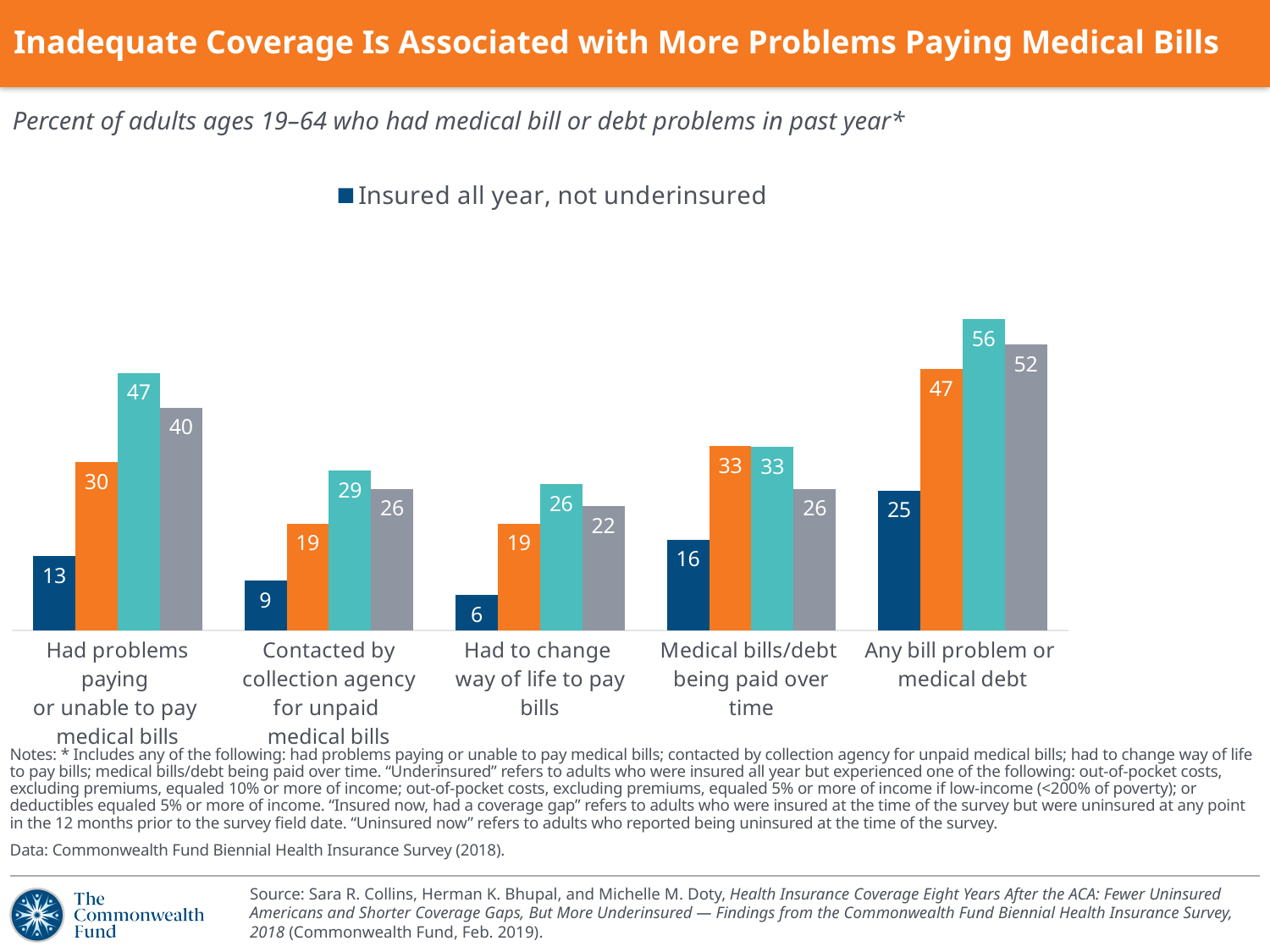
What is the value for 'Insured all year, not underinsured' in the 'Contacted by collection agency for unpaid medical bills' category? 9 In which category is the 'Insured all year, not underinsured' value highest? Any bill problem or medical debt What series name is shown in the chart's legend? Insured all year, not underinsured What is the highest value shown by any bar in the 'Any bill problem or medical debt' category? 56 What type of chart is shown on the slide? bar chart Which is larger for 'Insured all year, not underinsured': the value for 'Medical bills/debt being paid over time' or the value for 'Had problems paying or unable to pay medical bills'? Medical bills/debt being paid over time How many series does the chart's legend list? 1 What is the value for 'Insured all year, not underinsured' in the 'Had to change way of life to pay bills' category? 6 How many categories are shown along the x axis of the chart? 5 In which category is the 'Insured all year, not underinsured' value lowest? Had to change way of life to pay bills What is the value for 'Insured all year, not underinsured' in the 'Any bill problem or medical debt' category? 25 What is the difference between the 'Insured all year, not underinsured' values for 'Any bill problem or medical debt' and 'Had problems paying or unable to pay medical bills'? 12